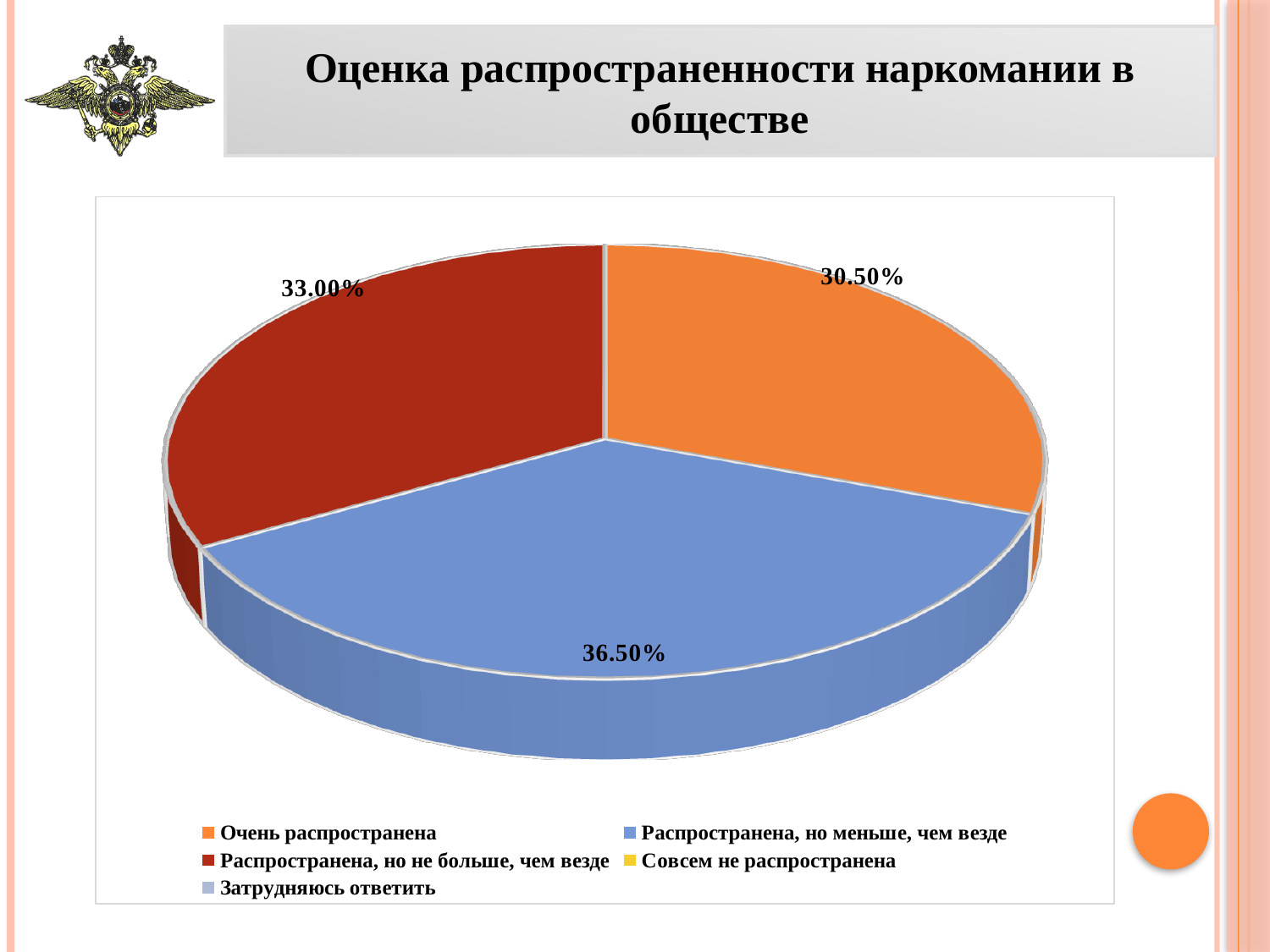
How many entries does the legend list? 5 What percentage is shown for the slice "Очень распространена"? 30.50% How many slices with data labels are visible in the pie? 3 Which of the labelled slices is the smallest? Очень распространена Which category has the largest slice of the pie? Распространена, но меньше, чем везде What colour is the slice for "Очень распространена"? orange What percentage is shown for the slice "Распространена, но меньше, чем везде"? 36.50% What is the title of the chart on the slide? Оценка распространенности наркомании в обществе Which slice is larger: "Распространена, но не больше, чем везде" or "Очень распространена"? Распространена, но не больше, чем везде What is the difference in percentage points between the "Распространена, но меньше, чем везде" slice and the "Очень распространена" slice? 6 percentage points What percentage is shown for the slice "Распространена, но не больше, чем везде"? 33.00% What kind of chart is shown on the slide? pie chart